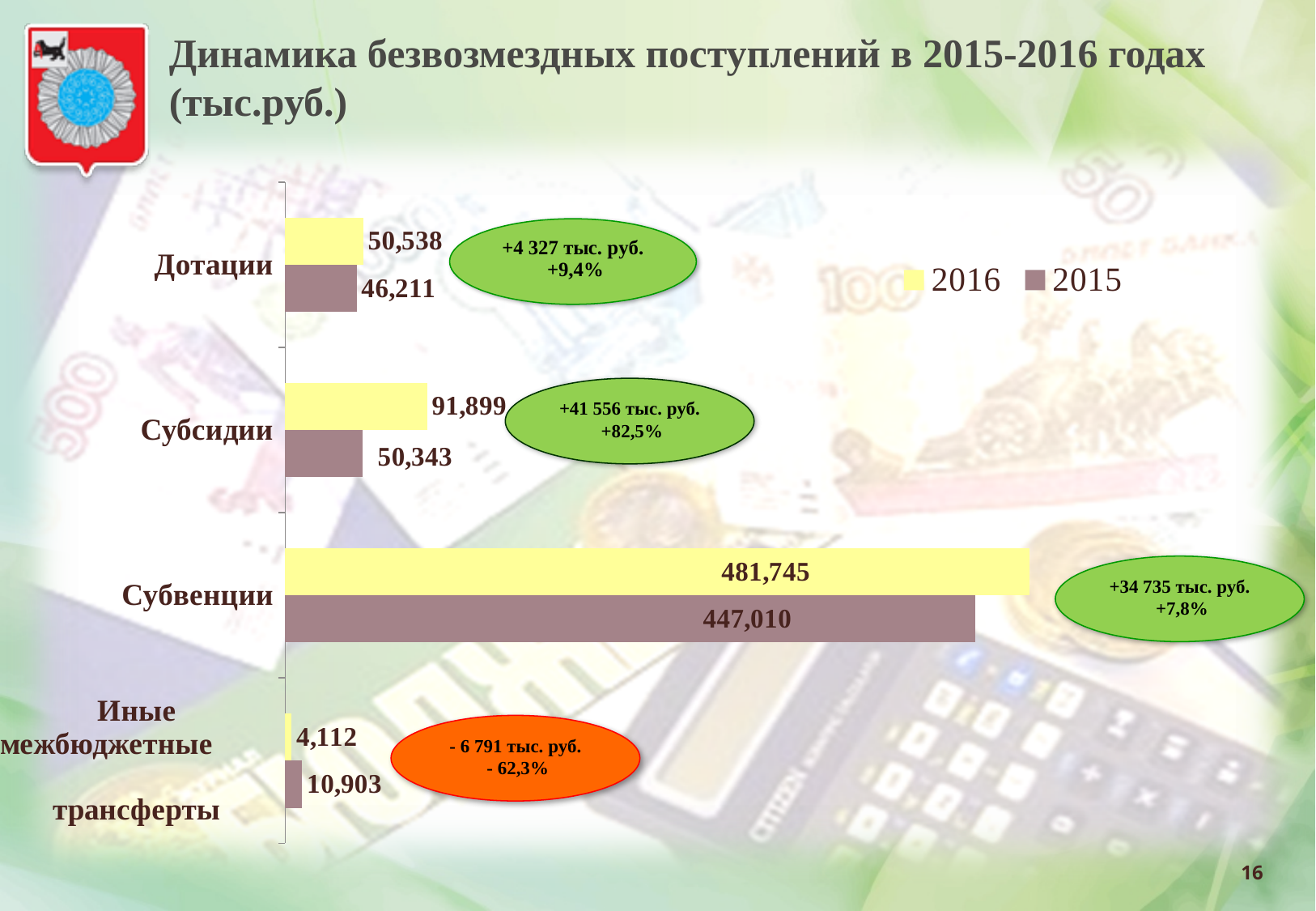
What is the difference between the 2015 and 2016 values for Иные межбюджетные трансферты? 6,791 Which category has the lowest 2015 value? Иные межбюджетные трансферты How many categories are shown in the chart? 4 What is the 2016 value for Субвенции? 481,745 For Дотации, which year has the larger value, 2016 or 2015? 2016 How many series does the legend list? 2 What is the 2015 value for Иные межбюджетные трансферты? 10,903 Which category has the highest 2016 value? Субвенции What is the 2015 value for Субсидии? 50,343 What is the 2016 value for Дотации? 50,538 What is the difference between the 2016 and 2015 values for Субсидии? 41,556 What kind of chart is shown on the slide? Bar chart